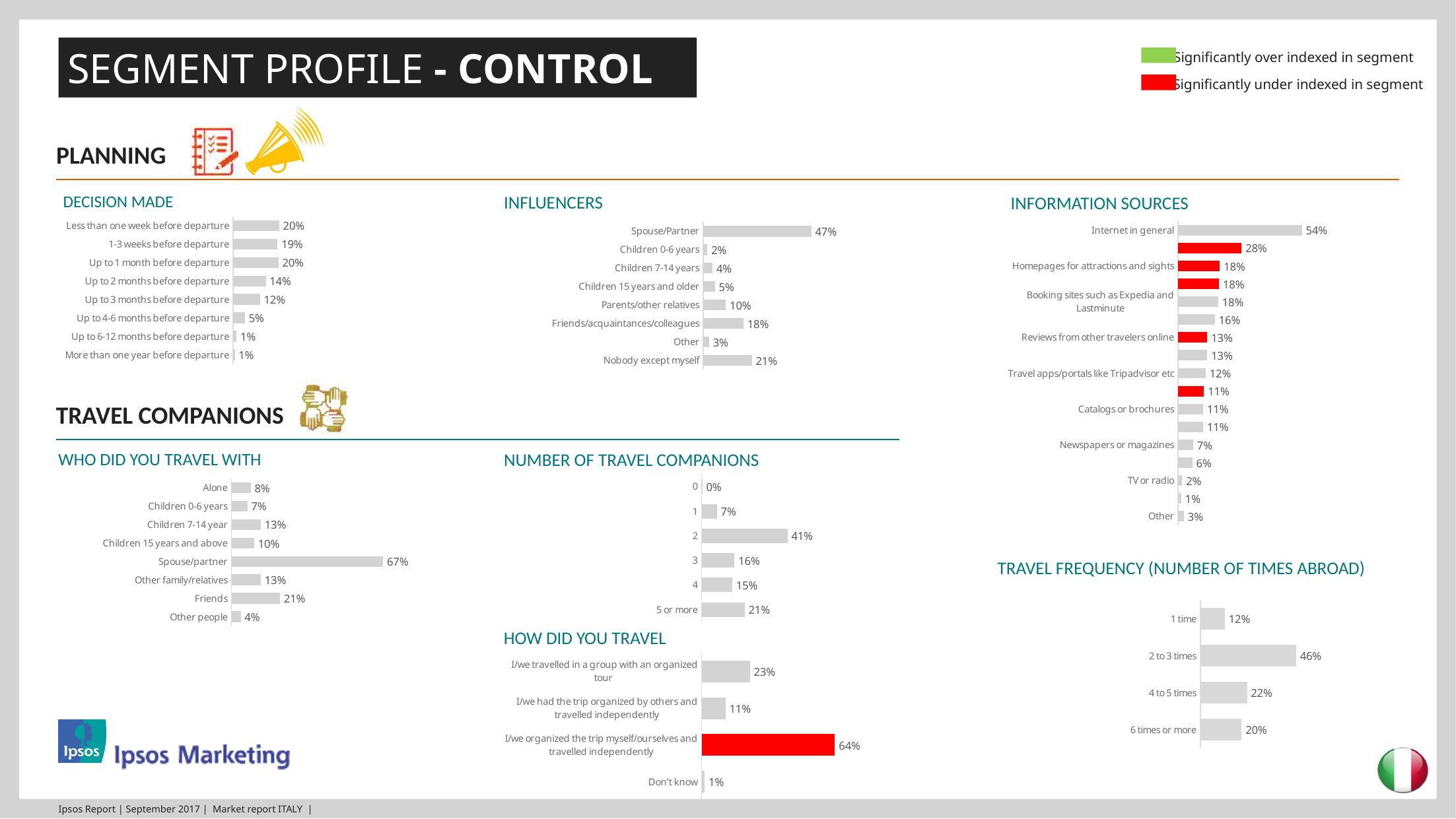
In the WHO DID YOU TRAVEL WITH chart, which category has the lowest value? Other people In the HOW DID YOU TRAVEL chart, what is the difference between 'I/we organized the trip myself/ourselves and travelled independently' and 'I/we travelled in a group with an organized tour'? 41% In the WHO DID YOU TRAVEL WITH chart, what is the value for 'Friends'? 21% What type of chart is the TRAVEL FREQUENCY (NUMBER OF TIMES ABROAD) chart? Bar chart In the INFLUENCERS chart, what is the difference between 'Nobody except myself' and 'Friends/acquaintances/colleagues'? 3% In the INFLUENCERS chart, which category has the highest value? Spouse/Partner In the NUMBER OF TRAVEL COMPANIONS chart, what is the value for '2'? 41% In the DECISION MADE chart, what is the value for 'Up to 2 months before departure'? 14% In the DECISION MADE chart, how many categories are shown? 8 In the INFORMATION SOURCES chart, what is the value for 'Internet in general'? 54% In the INFORMATION SOURCES chart, which is larger: 'Reviews from other travelers online' or 'Newspapers or magazines'? Reviews from other travelers online In the TRAVEL FREQUENCY (NUMBER OF TIMES ABROAD) chart, which category has the highest value? 2 to 3 times